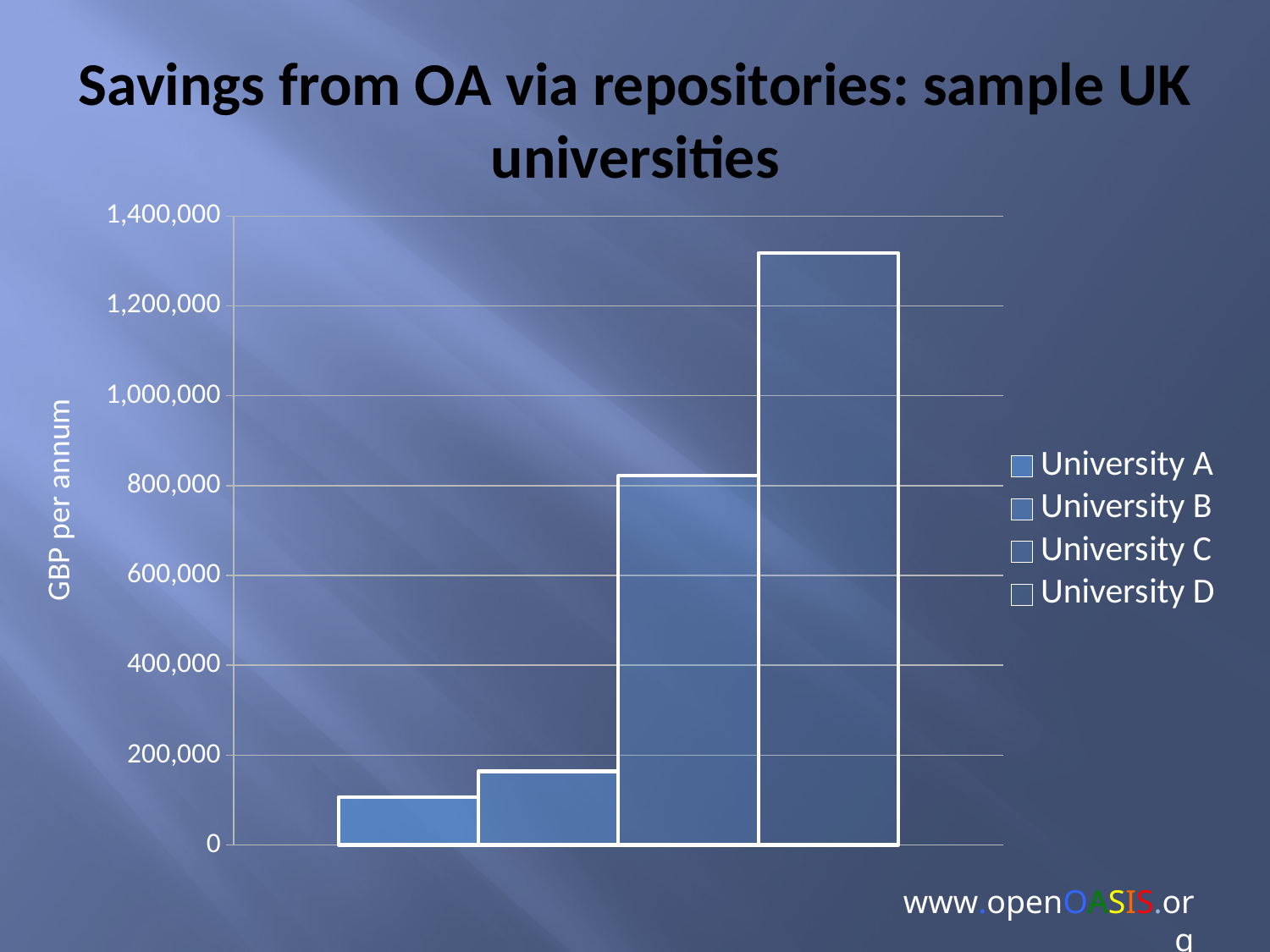
Which university has the highest savings? University D Is the value for University C greater or less than 600,000? greater Which university has the lowest savings? University A Which is larger, the value for University B or the value for University C? University C How many series does the legend list? 4 What is the label on the vertical axis of the chart? GBP per annum Is the value for University A greater or less than 200,000? less How many bars are plotted in the chart? 4 Do the bar values rise or fall from left to right across the chart? rise Is the value for University D greater or less than 1,200,000? greater What kind of chart is shown on the slide? bar chart